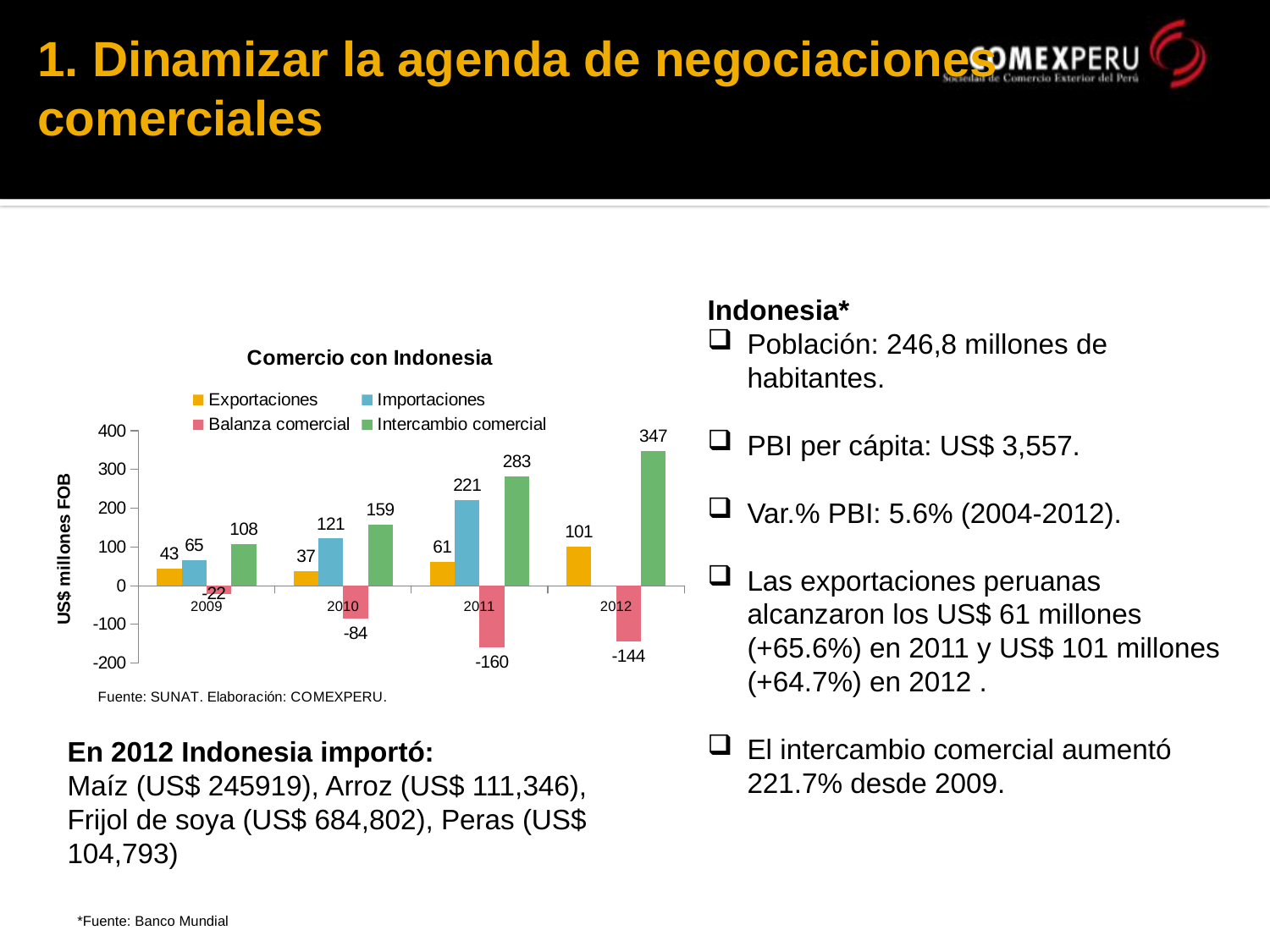
What is the value for Balanza comercial in 2012? -144 How many series does the legend list? 4 In which year is Intercambio comercial highest? 2012 Does Intercambio comercial rise or fall from 2009 to 2012? Rise What is the title of the chart? Comercio con Indonesia What is the value for Exportaciones in 2011? 61 Which is larger in 2009, Exportaciones or Importaciones? Importaciones What is the difference between Intercambio comercial in 2012 and in 2011? 64 What kind of chart is shown? Bar chart What is the value for Importaciones in 2010? 121 In which year is Exportaciones lowest? 2010 What is the value for Intercambio comercial in 2009? 108